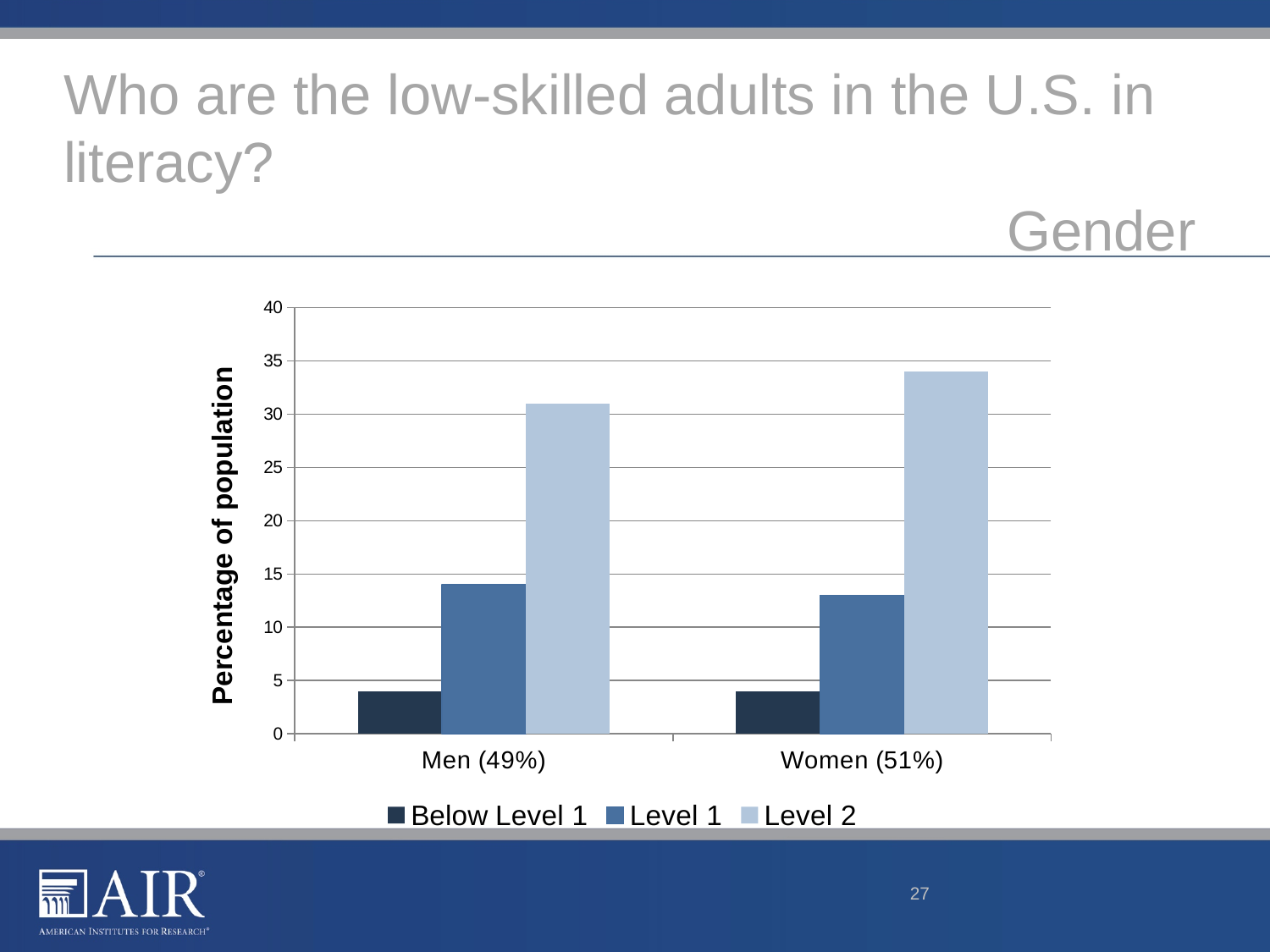
Is the Level 2 value for Men (49%) greater or less than 25? greater Which series has the lowest value for Women (51%)? Below Level 1 Is the Level 2 value larger for Men (49%) or Women (51%)? Women (51%) Which series has the highest value for Men (49%)? Level 2 What kind of chart is shown on the slide? bar chart Is the Level 2 value for Women (51%) greater or less than 30? greater Which legend entry is shown in the lightest blue colour? Level 2 How many categories are shown on the x axis? 2 Is the Level 1 value for Men (49%) greater or less than 10? greater How many series does the legend list? 3 What is the label of the y axis? Percentage of population